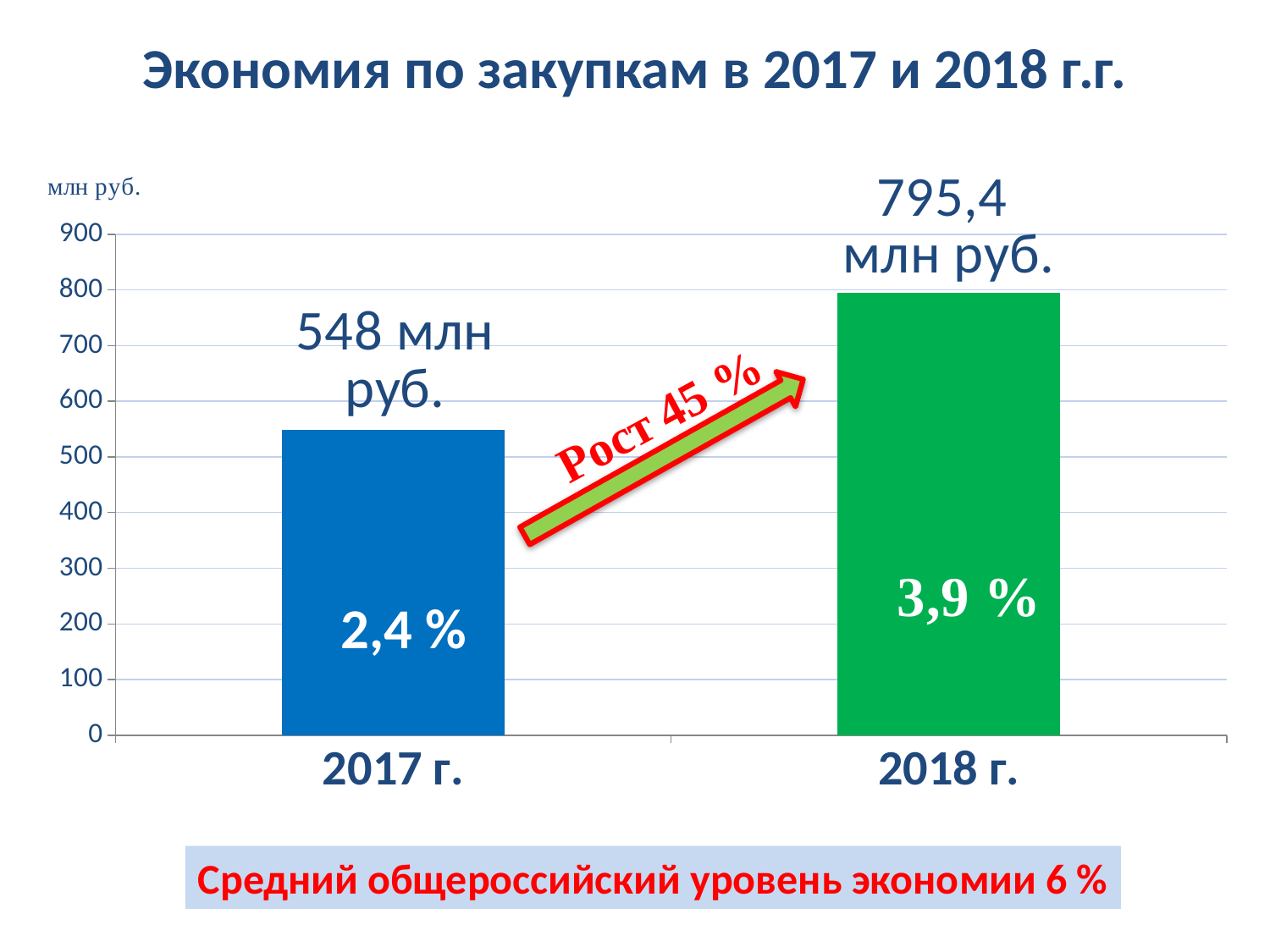
Is the value for 2017 г. greater or less than 600? less What is the value for 2018 г.? 795,4 млн руб. How many bars are shown in the chart? 2 Which year has the higher value? 2018 г. What is the value for 2017 г.? 548 млн руб. Do the values rise or fall from 2017 г. to 2018 г.? rise Is the value for 2018 г. greater or less than 700? greater What percentage is printed inside the bar for 2018 г.? 3,9 % What is the title of the chart? Экономия по закупкам в 2017 и 2018 г.г. Which year has the lower value? 2017 г. What is the difference between the values for 2018 г. and 2017 г.? 247,4 млн руб. What kind of chart is shown on the slide? bar chart